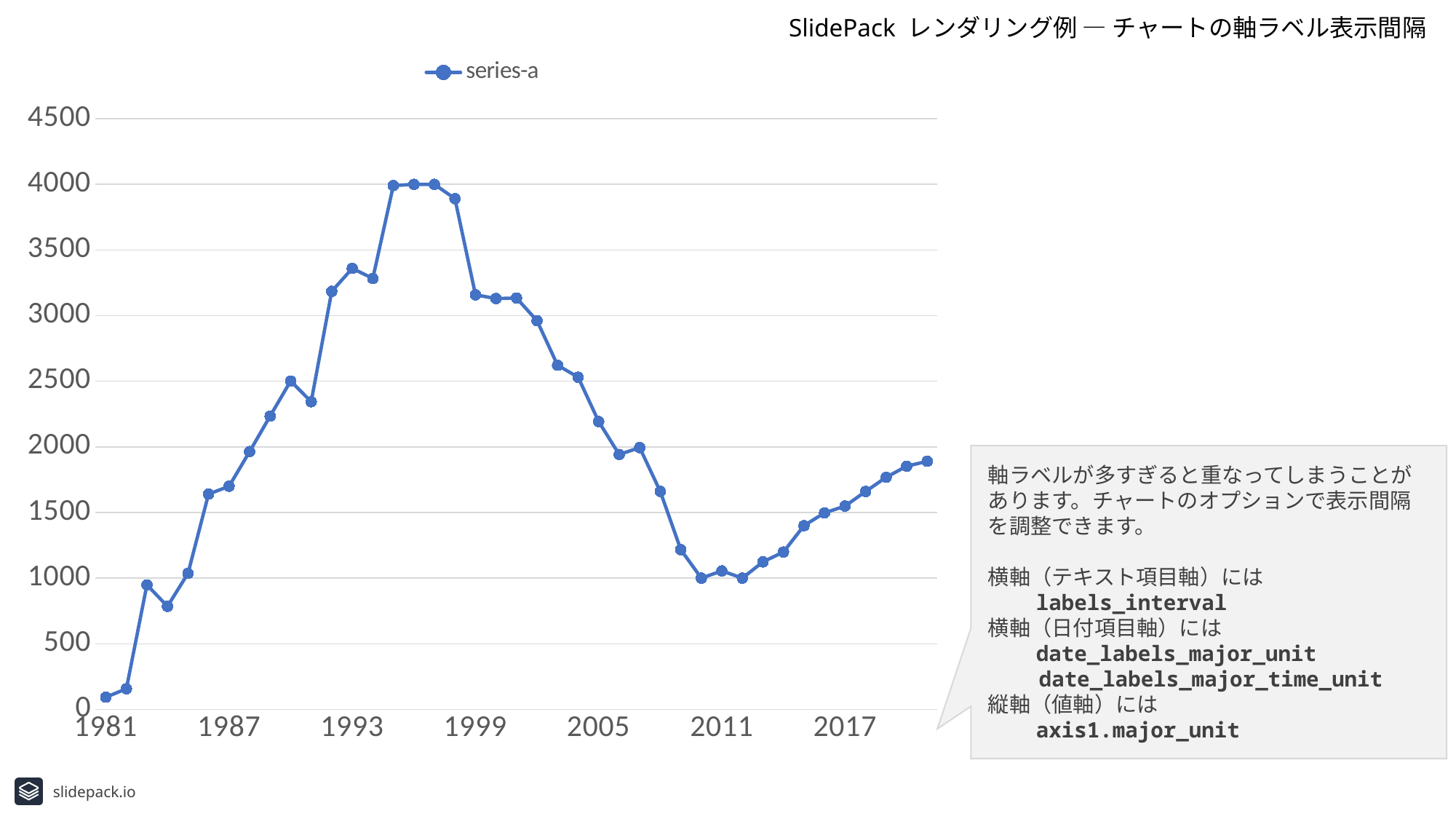
What is the name of the series shown in the legend? series-a Which has the larger value, 1993 or 2005? 1993 How many series does the legend list? 1 Is the value for 2017 greater or less than 2000? less Which has the larger value, 1981 or 2017? 2017 Is the value for 1993 greater or less than 3000? greater Do the values rise or fall between 1999 and 2011? fall Is the value for 1981 greater or less than 500? less What kind of chart is shown on the slide? line chart Do the values rise or fall between 1981 and 1993? rise